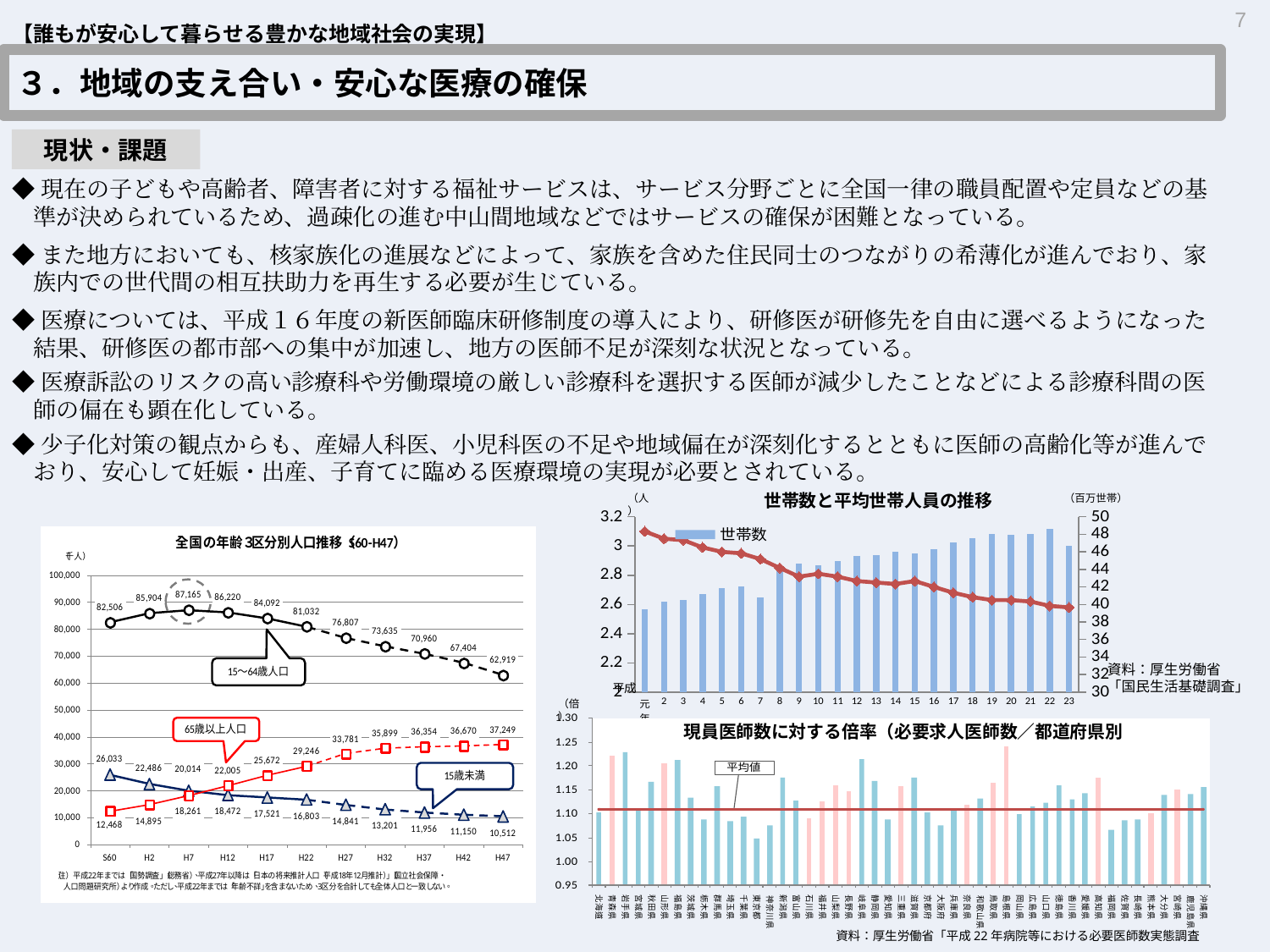
In the chart titled 全国の年齢3区分別人口推移（S60-H47）, how many data series are plotted? 3 In the chart titled 全国の年齢3区分別人口推移（S60-H47）, does 65歳以上人口 rise or fall from S60 to H47? rise What kind of chart is the one titled 世帯数と平均世帯人員の推移? Combination bar and line chart In the chart titled 全国の年齢3区分別人口推移（S60-H47）, what is the value of 15〜64歳人口 in H7? 87,165 In the chart titled 全国の年齢3区分別人口推移（S60-H47）, in which year is 15歳未満 lowest? H47 In the chart titled 全国の年齢3区分別人口推移（S60-H47）, in which year is 15〜64歳人口 highest? H7 In the chart titled 全国の年齢3区分別人口推移（S60-H47）, what is the difference between 15〜64歳人口 in S60 and in H47? 19,587 In the chart titled 全国の年齢3区分別人口推移（S60-H47）, how many time points are plotted on the x axis? 11 In the chart titled 世帯数と平均世帯人員の推移, is the 平均世帯人員 line value for 元年 greater or less than 3.0? greater In the chart titled 全国の年齢3区分別人口推移（S60-H47）, which is larger in H22: 65歳以上人口 or 15歳未満? 65歳以上人口 In the chart titled 全国の年齢3区分別人口推移（S60-H47）, what is the value of 65歳以上人口 in H47? 37,249 In the chart titled 全国の年齢3区分別人口推移（S60-H47）, what is the value of 15歳未満 in S60? 26,033